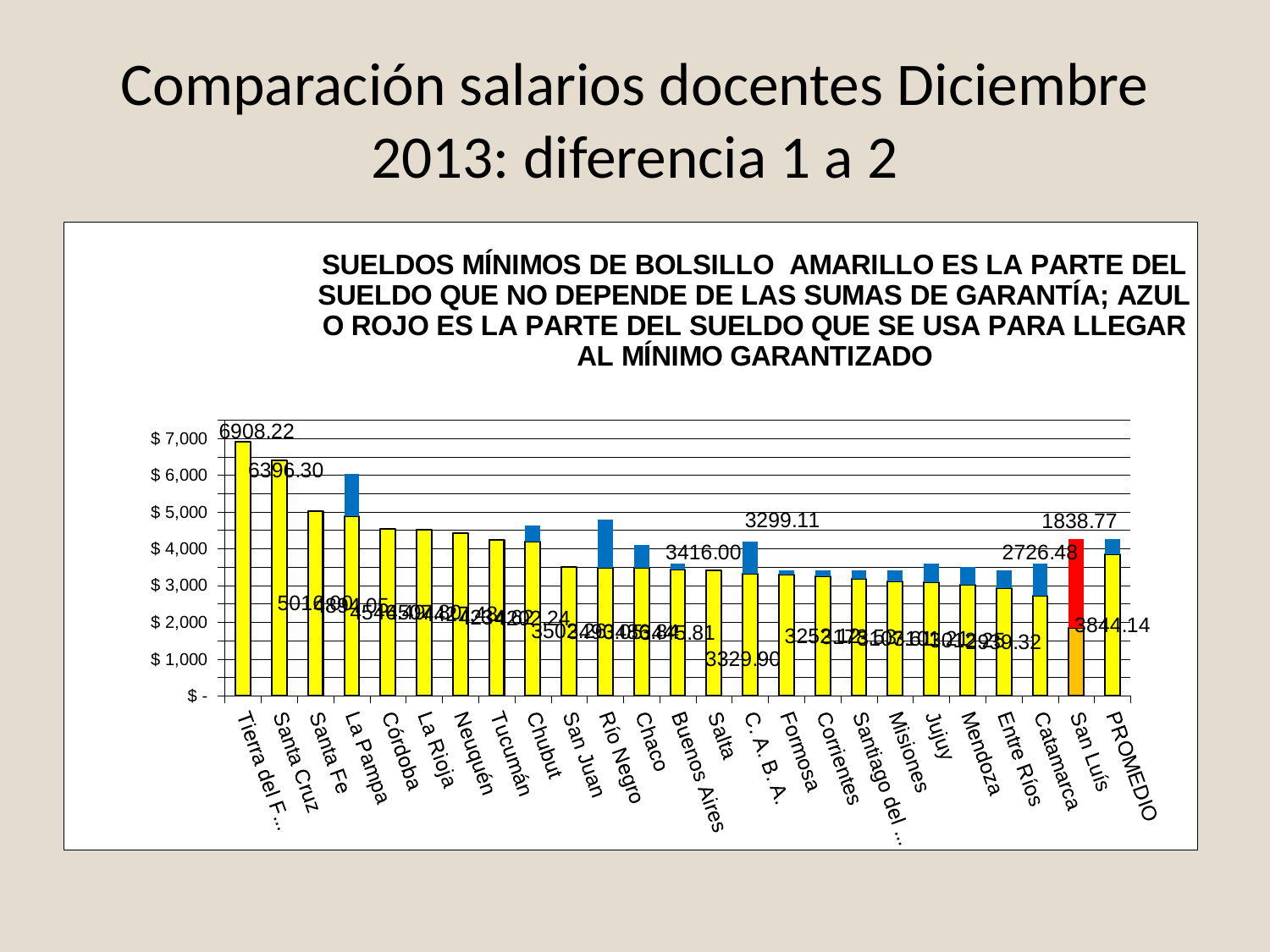
What type of chart is shown on the slide? Bar chart What is the value labelled for PROMEDIO? 3844.14 What is the value labelled for Tierra del Fuego? 6908.22 What colour is the bar for San Luis? Red What is the value labelled for Buenos Aires? 3445.81 What is the value labelled for Catamarca? 2726.48 How many categories are shown on the x axis of the chart? 25 What is the difference between the labelled values for Tierra del Fuego (6908.22) and Santa Cruz (6396.30)? 511.92 Which has the larger labelled value, Buenos Aires or Salta? Buenos Aires Is the value for Córdoba greater or less than 4,000? greater Which province has the highest bar in the chart? Tierra del Fuego What is the value labelled for Santa Cruz? 6396.30